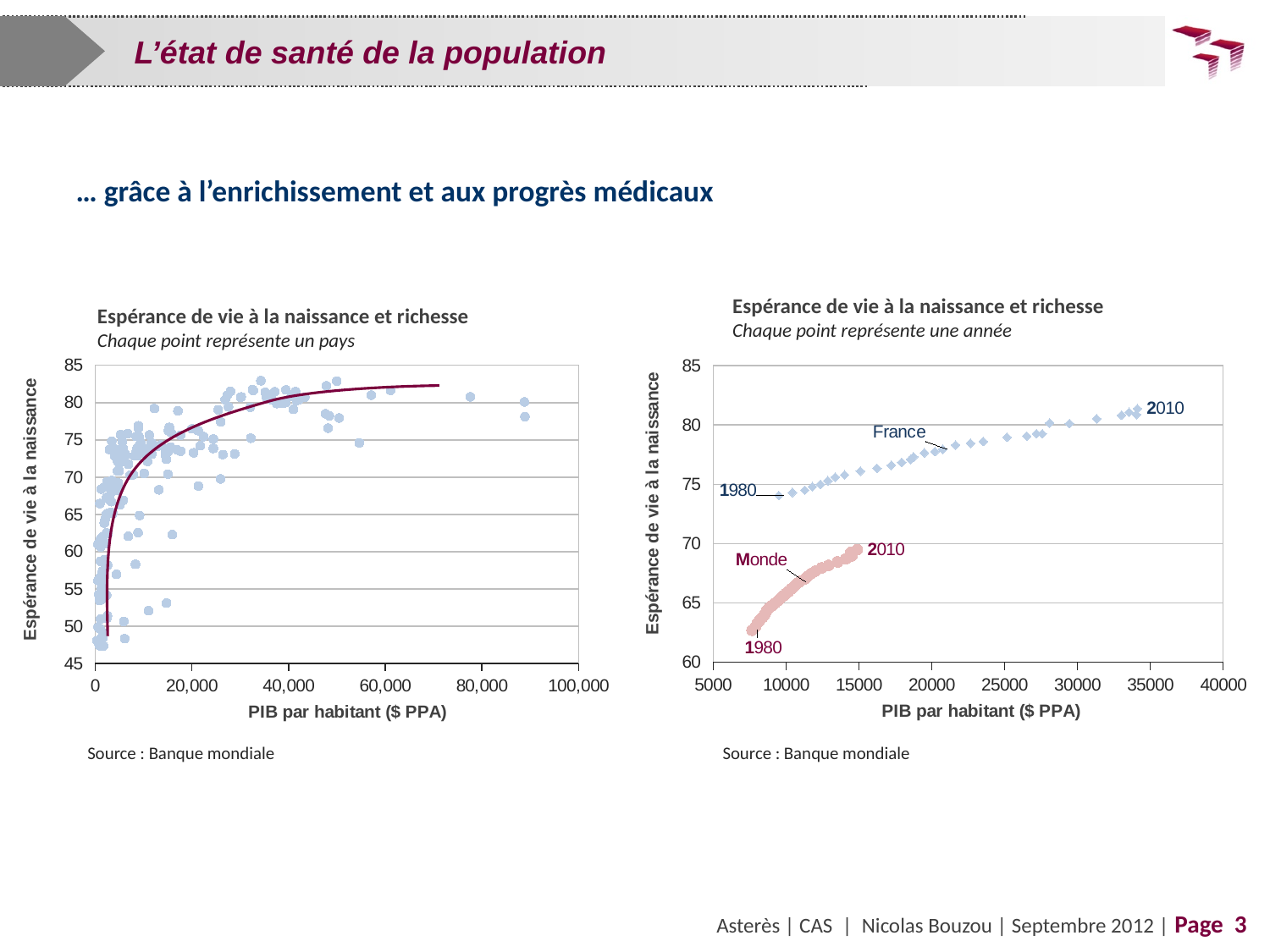
In the right chart, does life expectancy for France rise or fall from 1980 to 2010? Rise In the left chart (each point is a country), does life expectancy at birth generally rise or fall as GDP per capita increases? Rise What kind of chart is the right chart, 'Espérance de vie à la naissance et richesse – Chaque point représente une année'? Scatter plot What is the x-axis label of the left chart? PIB par habitant ($ PPA) What kind of chart is the left chart, 'Espérance de vie à la naissance et richesse – Chaque point représente un pays'? Scatter plot In the right chart, is the Monde (world) life expectancy at birth in 1980 greater or less than 65? less In the right chart, is the Monde (world) life expectancy at birth in 2010 greater or less than 75? less In the right chart, is France's GDP per capita in 2010 greater or less than 30000? greater In the right chart (each point is a year), which two series are labelled? France and Monde In the right chart, which series has the higher life expectancy at birth in 2010, France or Monde? France In the right chart (each point is a year), how many series are plotted? 2